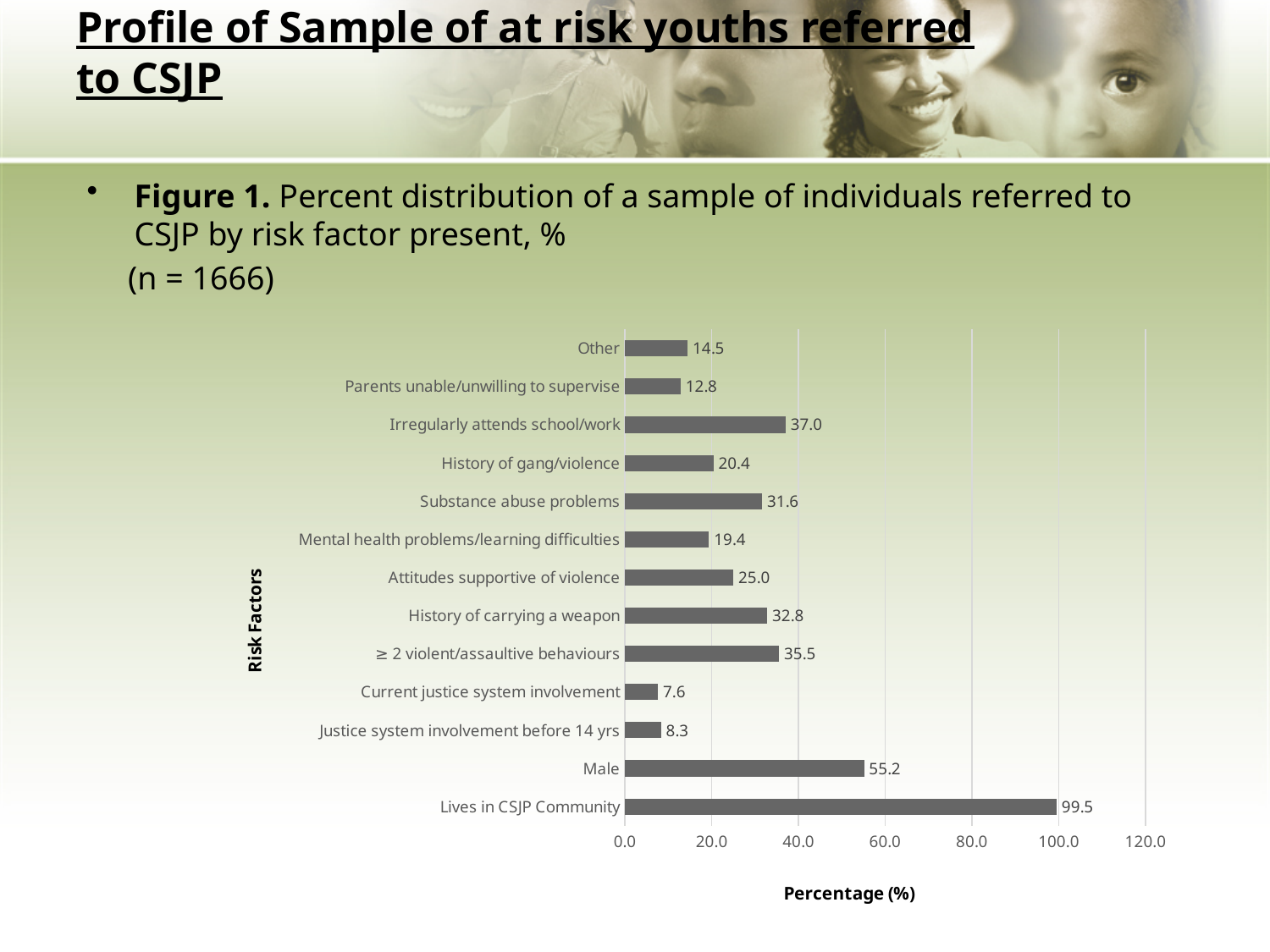
What kind of chart is shown on the slide? bar chart What is the label of the horizontal axis? Percentage (%) Is the value for ≥ 2 violent/assaultive behaviours greater or less than 40.0? less How many risk factor categories are shown in the chart? 13 Which risk factor has the highest value? Lives in CSJP Community Which risk factor has the lowest value? Current justice system involvement What is the value for Substance abuse problems? 31.6 Which is larger, the value for History of gang/violence or the value for Mental health problems/learning difficulties? History of gang/violence What is the label of the vertical axis? Risk Factors What is the value for Irregularly attends school/work? 37.0 What is the difference between the values for Male and History of carrying a weapon? 22.4 What is the value for Lives in CSJP Community? 99.5